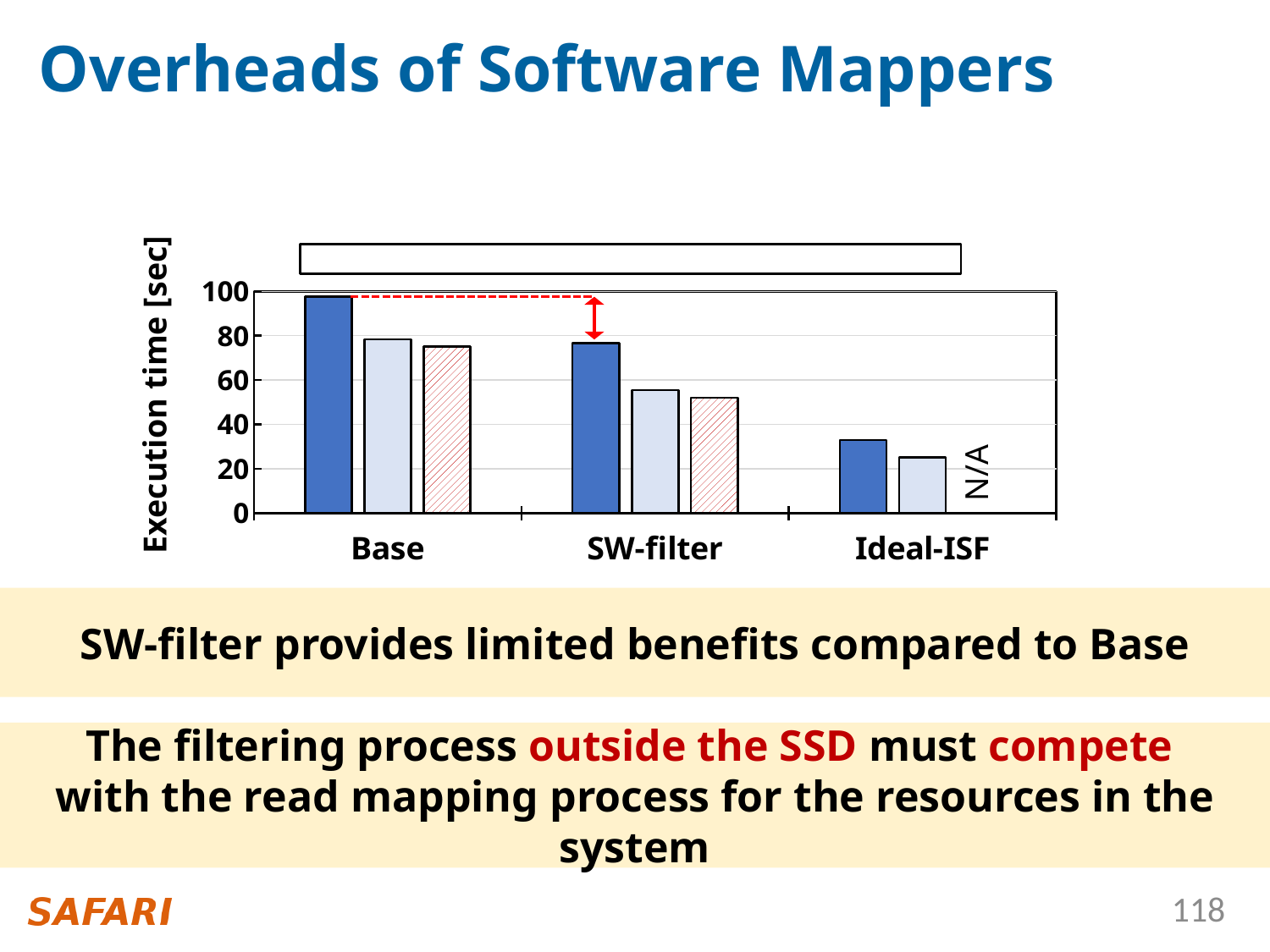
How many categories are shown on the x axis of the chart? 3 What kind of chart is shown on the slide? bar chart Which is larger, the light blue bar for Base or the light blue bar for SW-filter? Base Is the dark blue bar for Base greater or less than 80? greater Is the dark blue bar for Ideal-ISF greater or less than 40? less Which category has the shortest dark blue bar? Ideal-ISF What is shown in place of the third (red hatched) bar for Ideal-ISF? N/A What is the label of the y axis of the chart? Execution time [sec] Is the light blue bar for SW-filter greater or less than 60? less Do the dark blue bars rise or fall from Base to Ideal-ISF along the x axis? fall Which category has the tallest dark blue bar? Base